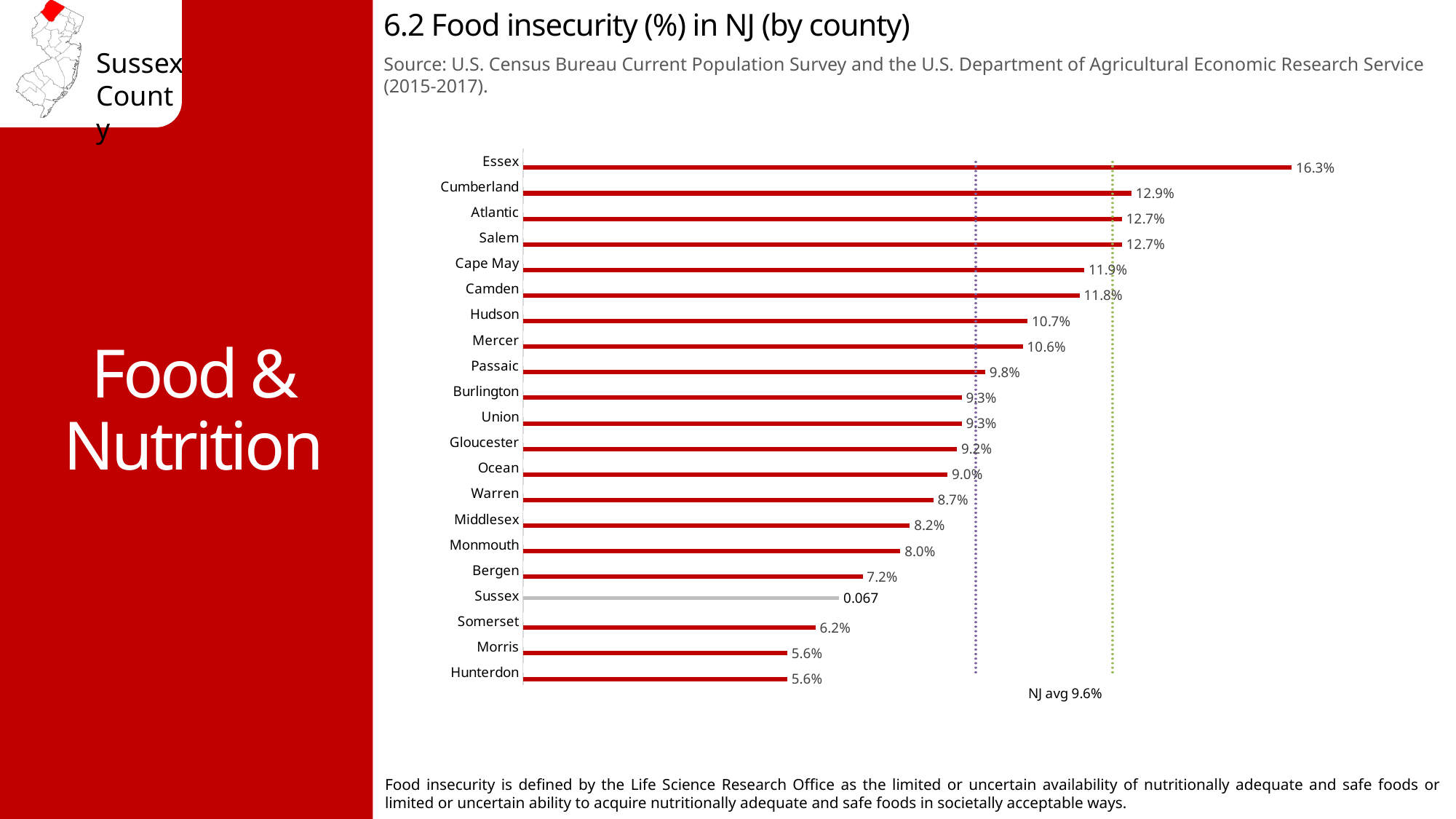
What NJ average value is noted on the chart? 9.6% What is the food insecurity value for Bergen? 7.2% What is the difference between the values for Essex and Cumberland? 3.4 percentage points Which county has the highest food insecurity value? Essex Which county's bar is drawn in grey instead of red? Sussex What is the difference between the values for Bergen and Somerset? 1.0 percentage point What type of chart is shown on the slide? Bar chart What is the food insecurity value for Essex? 16.3% What is the food insecurity value for Cumberland? 12.9% How many counties are shown in the chart? 21 What value is labeled for Sussex? 0.067 Which has a higher food insecurity value, Passaic or Warren? Passaic